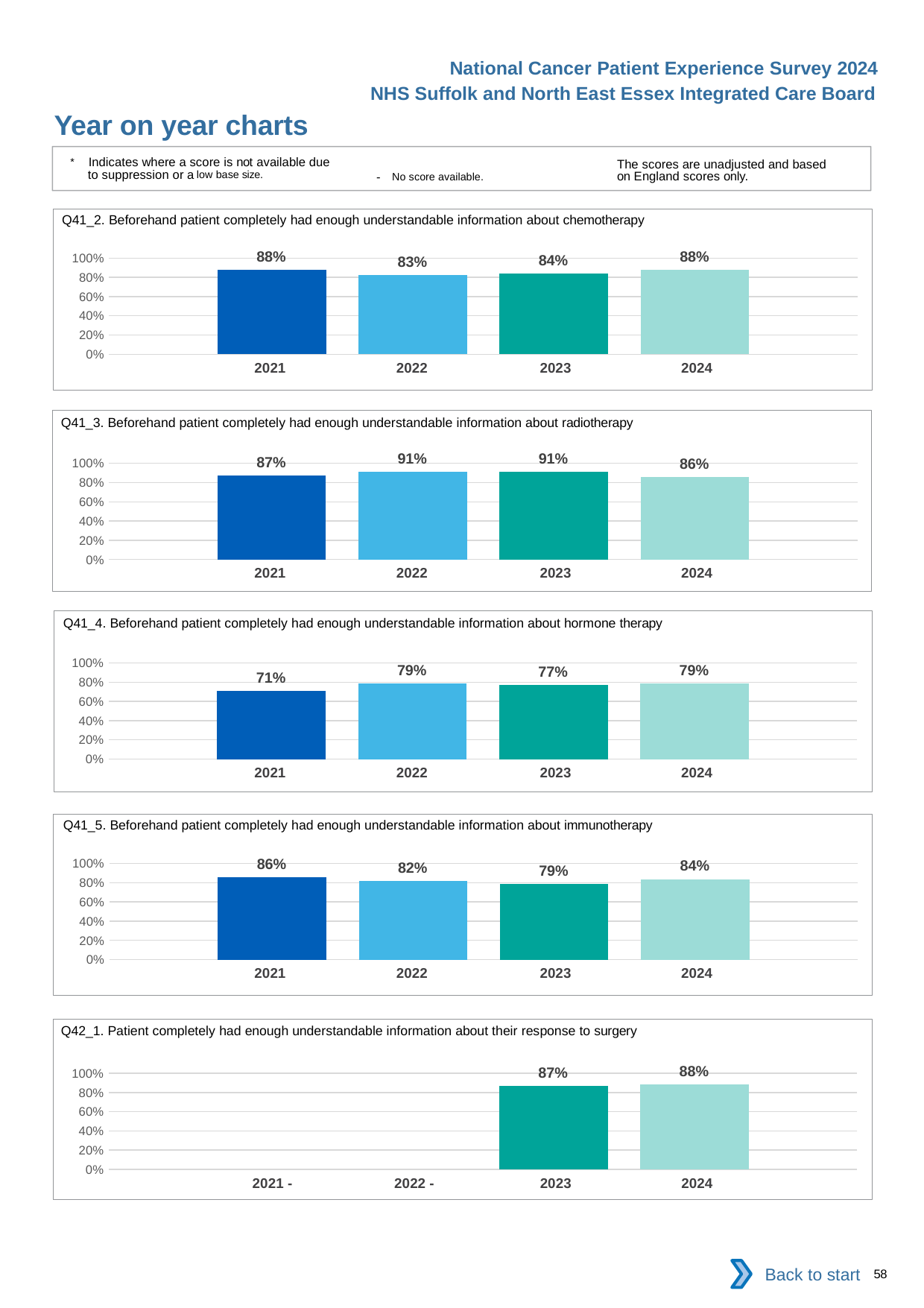
In the Q41_4 chart (hormone therapy), what is the difference between the 2022 and 2021 values? 8 percentage points In the Q41_4 chart (hormone therapy), which year has the lowest value? 2021 In the Q41_5 chart (immunotherapy), is the value for 2023 larger or smaller than the value for 2024? smaller In the Q41_3 chart (radiotherapy), what is the difference between the 2023 and 2024 values? 5 percentage points In the Q41_5 chart (immunotherapy), which year has the highest value? 2021 In the Q42_1 chart (response to surgery), what is the value for 2024? 88% How many charts are shown on the slide? 5 What type of chart is the Q41_2 chart (chemotherapy)? bar chart In the Q41_3 chart (radiotherapy), which year has the lowest value? 2024 In the Q41_2 chart (chemotherapy), what is the value for 2022? 83% How many years have a plotted bar in the Q42_1 chart (response to surgery)? 2 In the Q41_2 chart (chemotherapy), is the value for 2021 greater or less than 80%? greater